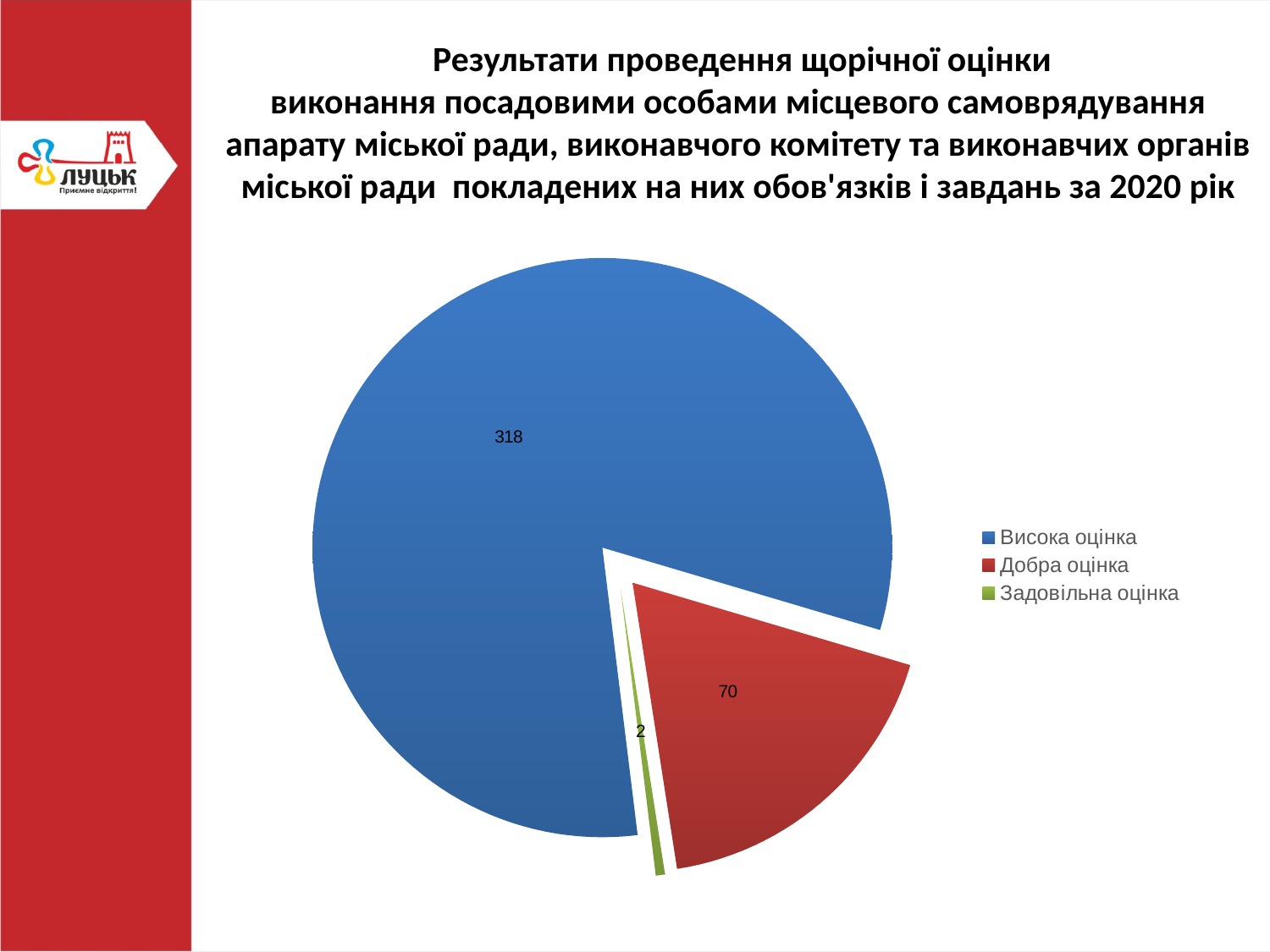
Which category has the largest slice of the pie? Висока оцінка What is the difference between the values for Висока оцінка and Добра оцінка? 248 What type of chart is shown on the slide? pie chart What is the value for Задовільна оцінка? 2 What colour is the slice for Добра оцінка? red What is the value for Добра оцінка? 70 What is the difference between the values for Добра оцінка and Задовільна оцінка? 68 What is the value for Висока оцінка? 318 How many categories does the pie chart have? 3 Which is larger, the value for Добра оцінка or the value for Задовільна оцінка? Добра оцінка Which category has the smallest slice of the pie? Задовільна оцінка What is the total of all slices in the pie chart? 390